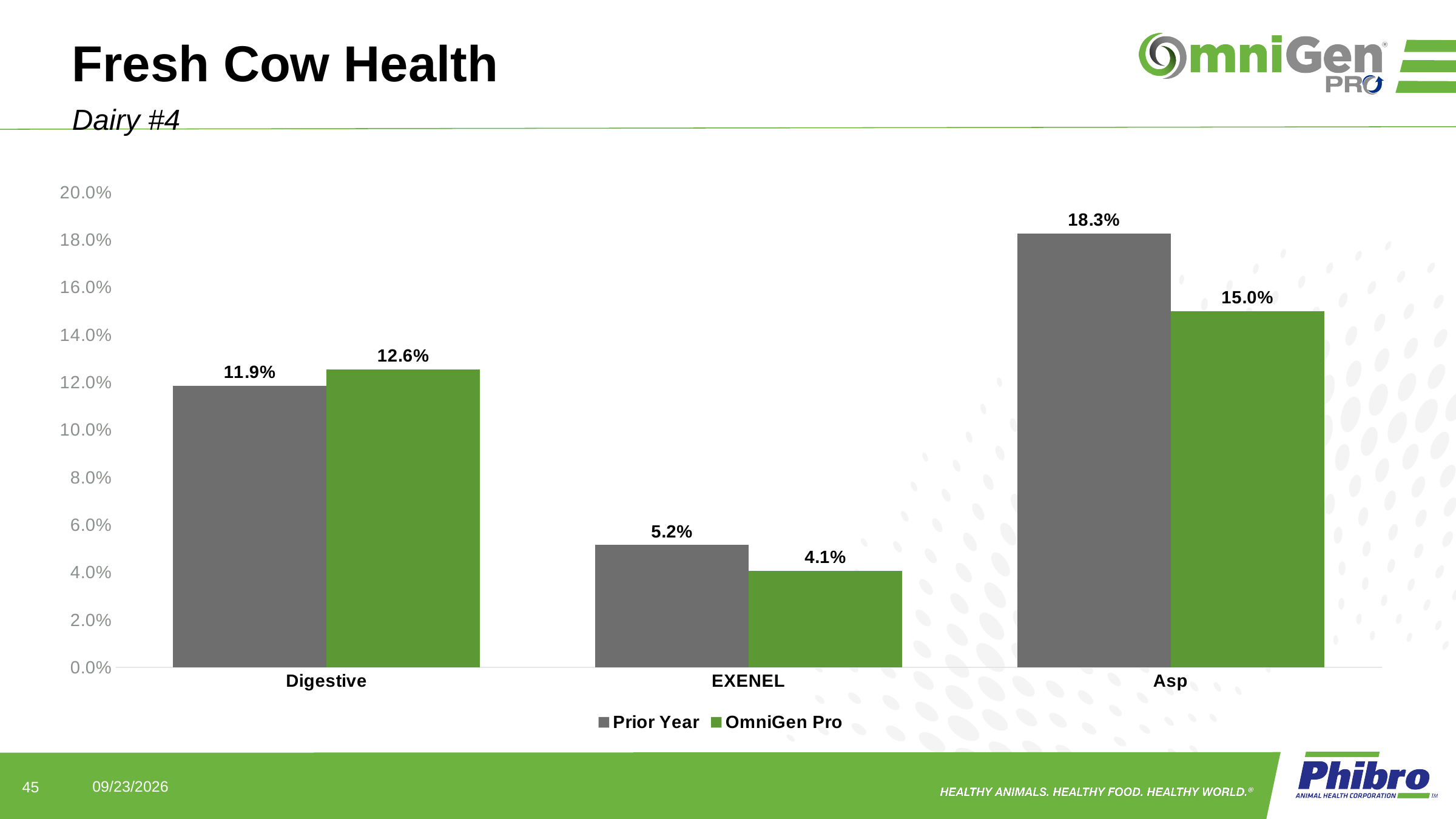
What is the difference between the Prior Year and OmniGen Pro values for Asp? 3.3% What is the OmniGen Pro value for Asp? 15.0% What is the OmniGen Pro value for EXENEL? 4.1% What kind of chart is shown on the slide? Bar chart For EXENEL, which is larger: the Prior Year value or the OmniGen Pro value? Prior Year What is the difference between the OmniGen Pro and Prior Year values for Digestive? 0.7% How many series does the legend list? 2 Which category has the lowest OmniGen Pro value? EXENEL How many categories are shown on the x axis? 3 What colour are the OmniGen Pro bars? Green Which category has the highest Prior Year value? Asp What is the Prior Year value for Digestive? 11.9%